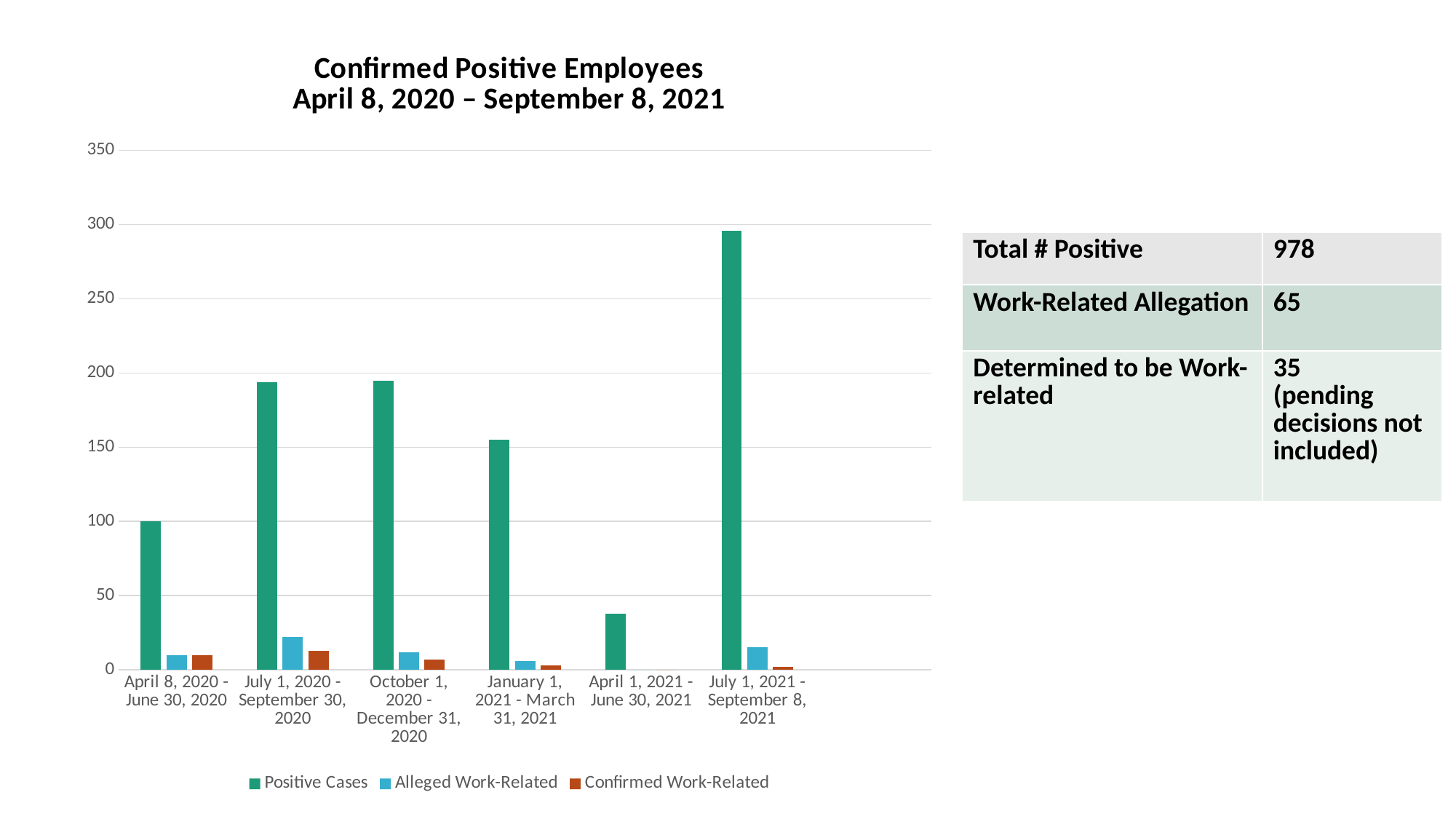
What kind of chart is shown on the slide? bar chart Which series is shown in green in the chart? Positive Cases What is the title of the chart? Confirmed Positive Employees April 8, 2020 – September 8, 2021 Which time period has the highest number of Alleged Work-Related cases? July 1, 2020 - September 30, 2020 Is the value for Positive Cases in April 1, 2021 - June 30, 2021 greater or less than 50? less Which time period has the highest number of Positive Cases? July 1, 2021 - September 8, 2021 Which time period has the lowest number of Positive Cases? April 1, 2021 - June 30, 2021 Which is larger: Positive Cases in January 1, 2021 - March 31, 2021 or Positive Cases in April 1, 2021 - June 30, 2021? January 1, 2021 - March 31, 2021 How many series does the chart legend list? 3 How many time periods are shown on the x axis of the chart? 6 Is the value for Positive Cases in July 1, 2021 - September 8, 2021 greater or less than 250? greater